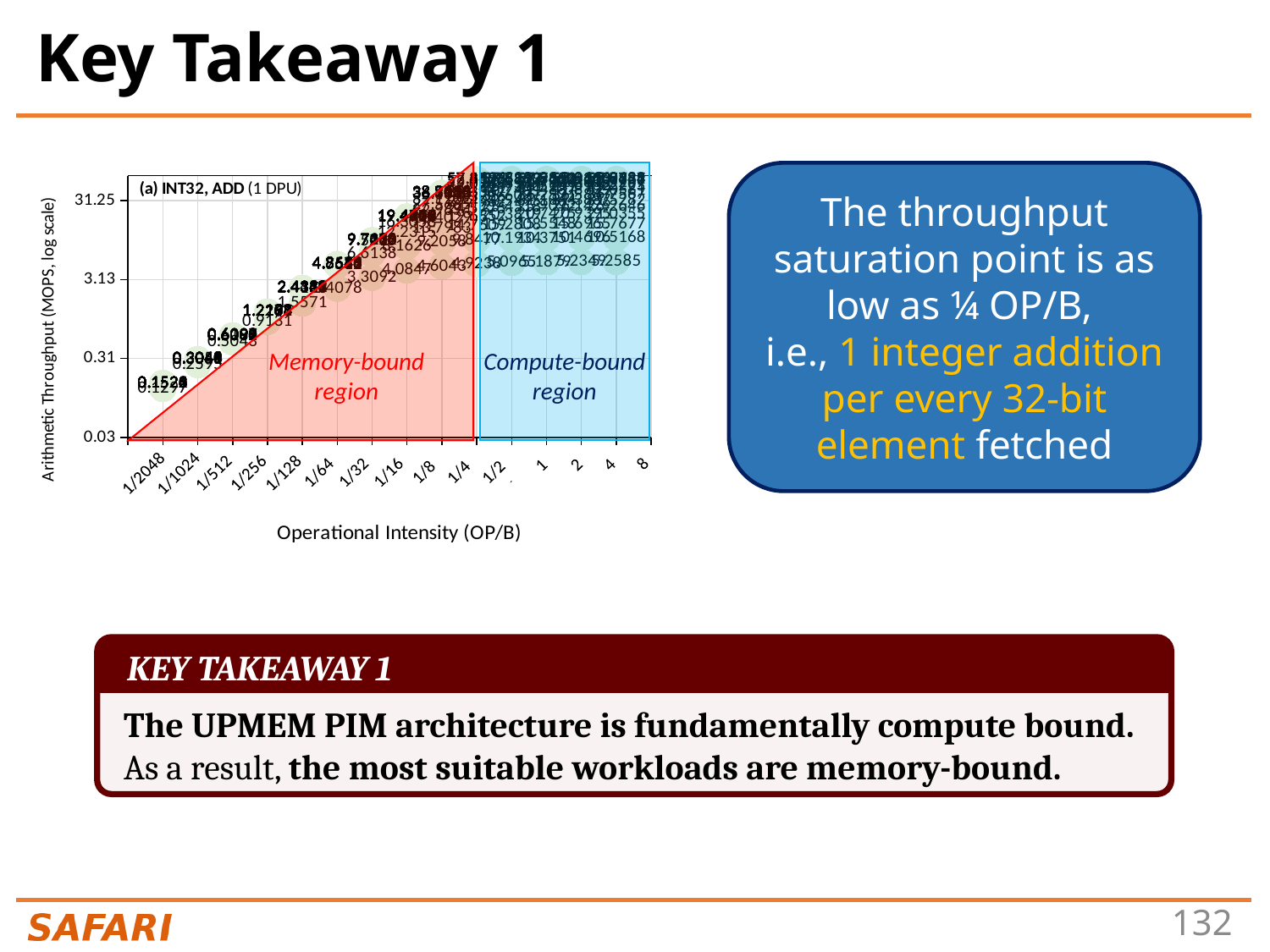
Is the throughput at operational intensity 1/4 greater or less than 3.13 MOPS? greater Do the throughput values rise or fall as operational intensity increases from 1/2048 to 1/4? rise Is the throughput at operational intensity 8 greater or less than 3.13 MOPS? greater What kind of chart is shown on the slide? scatter chart Which has the higher arithmetic throughput: operational intensity 1/1024 or 1/128? 1/128 Is the throughput at operational intensity 1/2048 greater or less than 0.31 MOPS? less How many tick labels are shown on the x axis of the chart? 15 What is the label of the y axis of the chart? Arithmetic Throughput (MOPS, log scale) What is the label of the x axis of the chart? Operational Intensity (OP/B) Which operational intensity has the lowest arithmetic throughput in the chart? 1/2048